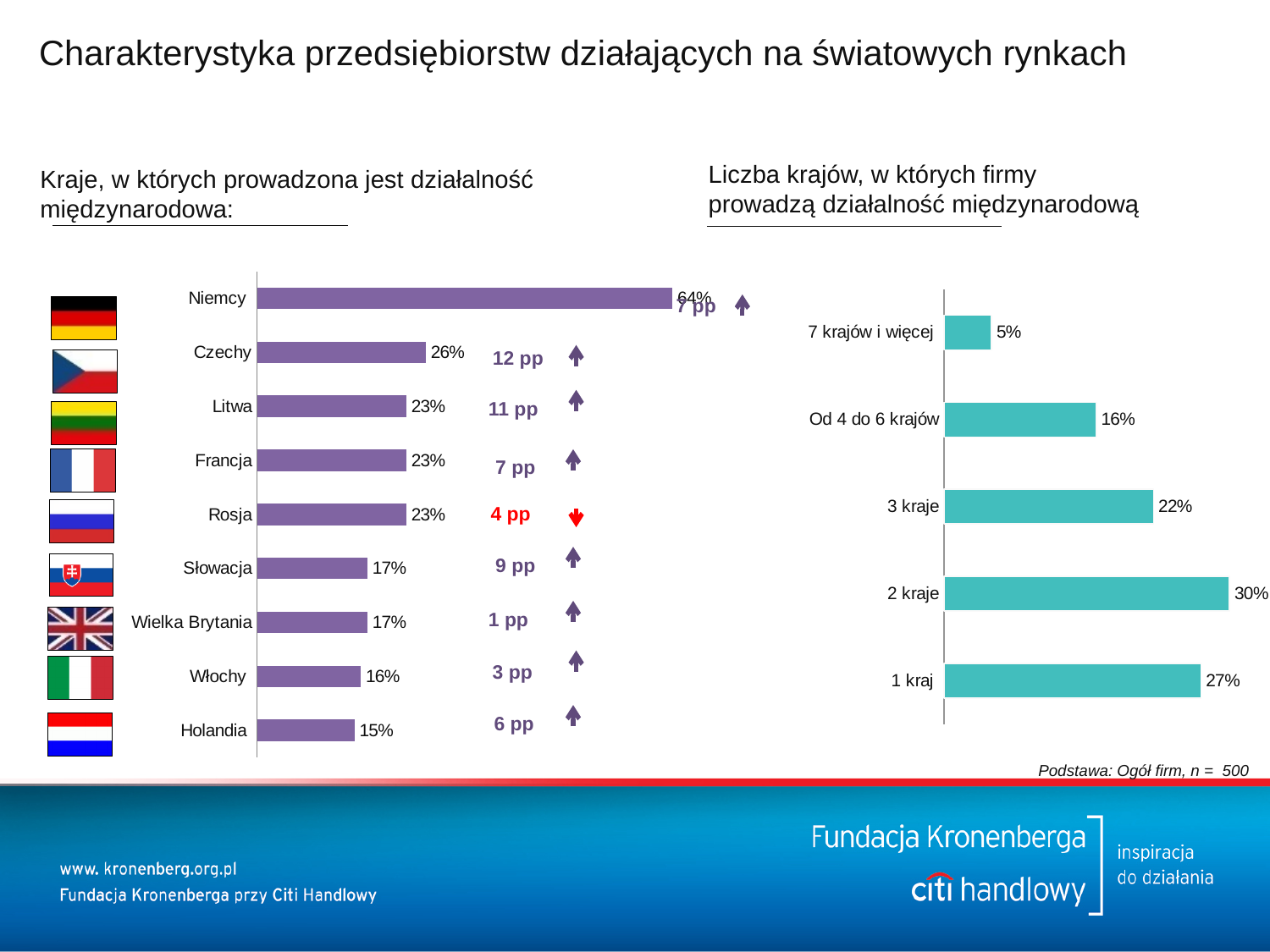
In the right chart (Liczba krajów, w których firmy prowadzą działalność międzynarodową), how many categories are shown? 5 In the left chart (Kraje, w których prowadzona jest działalność międzynarodowa), which country has the highest value? Niemcy In the right chart (Liczba krajów, w których firmy prowadzą działalność międzynarodową), what is the value for 7 krajów i więcej? 5% In the right chart (Liczba krajów, w których firmy prowadzą działalność międzynarodową), what is the value for 2 kraje? 30% In the left chart (Kraje, w których prowadzona jest działalność międzynarodowa), what is the value for Czechy? 26% In the left chart (Kraje, w których prowadzona jest działalność międzynarodowa), which is larger: the value for Słowacja or the value for Holandia? Słowacja What type of chart is the right chart (Liczba krajów, w których firmy prowadzą działalność międzynarodową)? Bar chart In the left chart (Kraje, w których prowadzona jest działalność międzynarodowa), what is the difference between the values for Niemcy and Czechy? 38 percentage points In the left chart (Kraje, w których prowadzona jest działalność międzynarodowa), what is the value for Niemcy? 64% In the left chart (Kraje, w których prowadzona jest działalność międzynarodowa), how many countries are listed? 9 In the right chart (Liczba krajów, w których firmy prowadzą działalność międzynarodową), which category has the highest value? 2 kraje In the left chart (Kraje, w których prowadzona jest działalność międzynarodowa), which country has the lowest value? Holandia